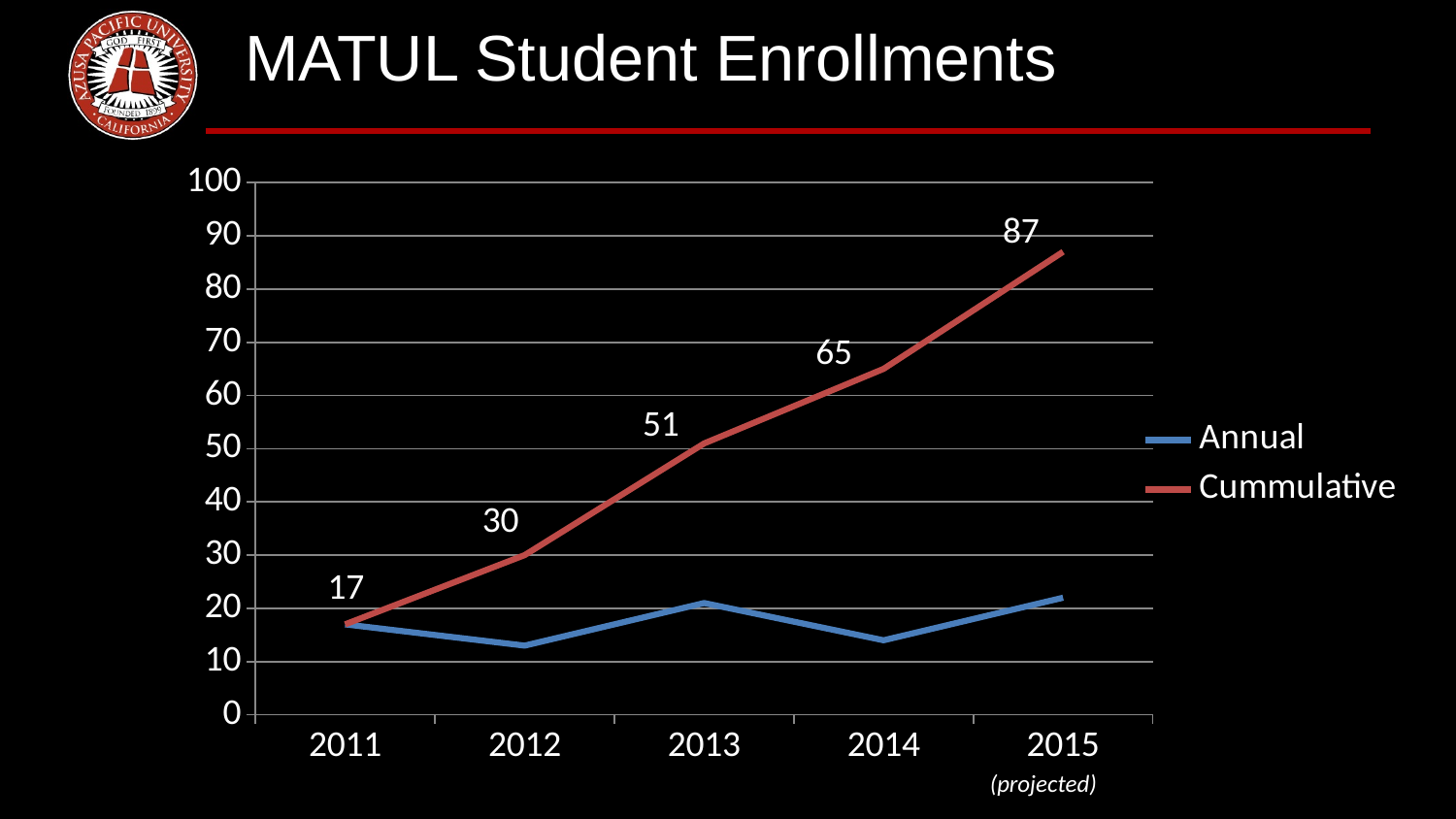
What is the Cummulative value for 2015? 87 How many series does the legend list? 2 What is the Cummulative value for 2013? 51 What is the Cummulative value for 2011? 17 Does the Cummulative series rise or fall from 2011 to 2015? rise In which year is the Cummulative series highest? 2015 In which year is the Cummulative series lowest? 2011 Is the Annual value for 2012 greater or less than 20? less Which is larger in 2015, the Annual value or the Cummulative value? Cummulative What kind of chart is shown on the slide? line chart What is the difference between the Cummulative values for 2014 and 2012? 35 How many years are shown on the x axis? 5